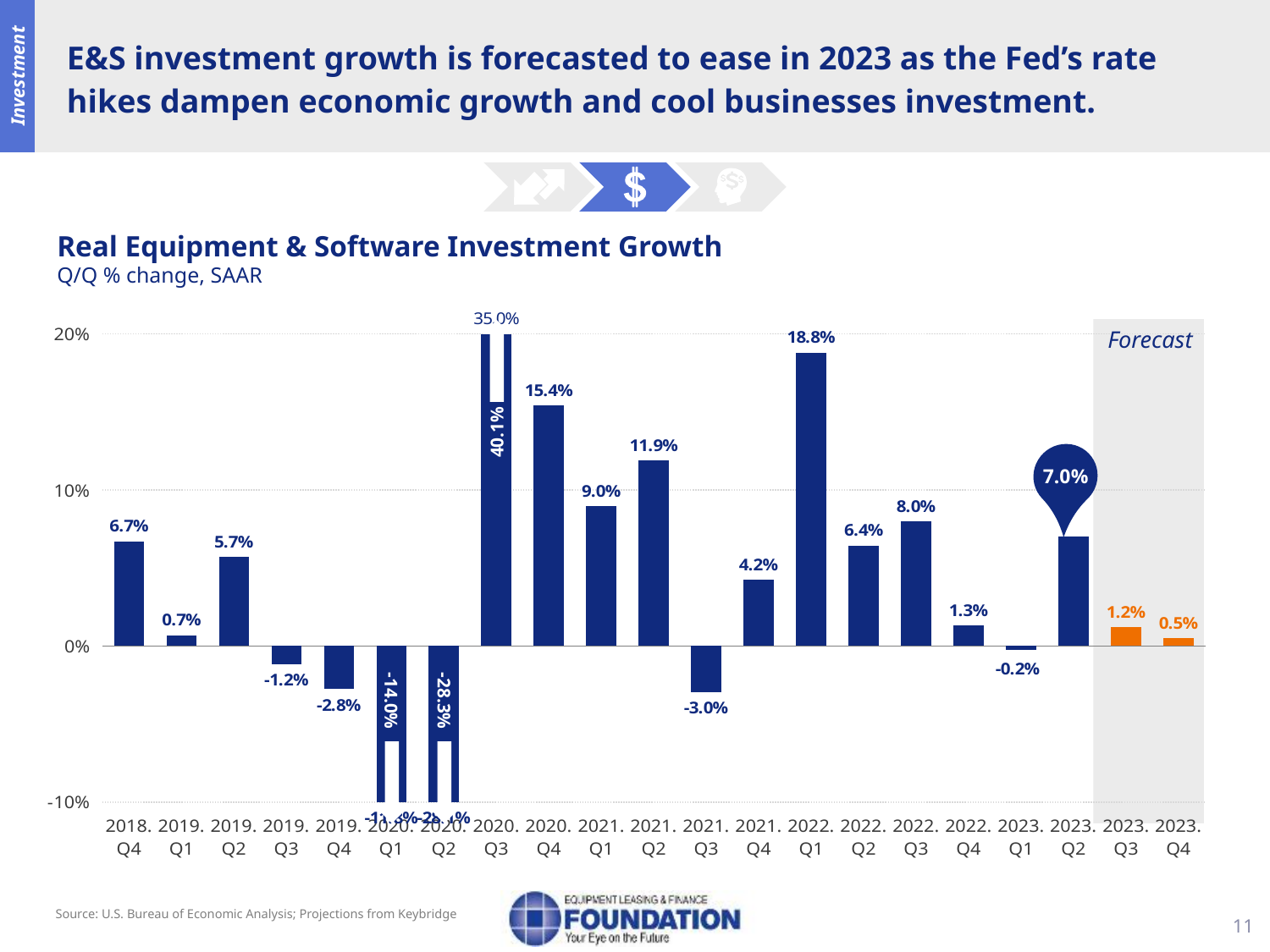
What is the value for 2023 Q2 in the chart? 7.0% What is the forecast value for 2023 Q4? 0.5% Is the value for 2021 Q1 greater or less than 10%? less Do the values rise or fall from 2022 Q1 to 2022 Q2? Fall Which is larger, the value for 2020 Q4 or the value for 2021 Q2? 2020 Q4 Which quarter has the lowest value in the chart? 2020 Q2 Which quarters are shaded as Forecast in the chart? 2023 Q3 and 2023 Q4 Which quarter has the highest value in the chart? 2020 Q3 How many quarters are plotted in the chart? 21 What kind of chart is shown on the slide? Bar chart What is the difference between the values for 2022 Q1 and 2022 Q2? 12.4 percentage points What is the value for 2022 Q1 in the Real Equipment & Software Investment Growth chart? 18.8%